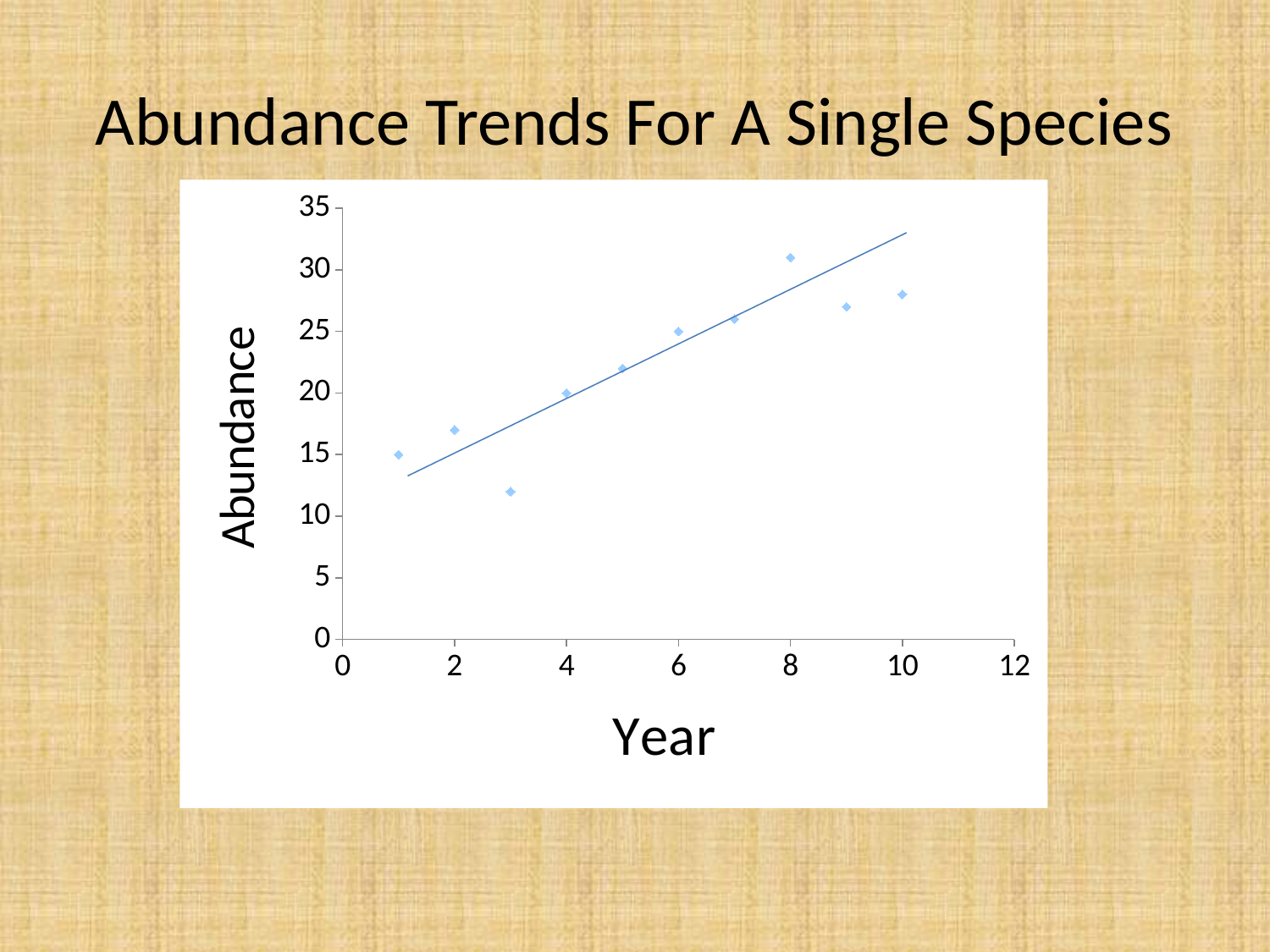
What is the title of the chart? Abundance Trends For A Single Species What is the abundance value in year 1? 15 In which year is abundance highest? 8 What is the label of the y axis? Abundance What kind of chart is shown on the slide? scatter chart Is the abundance value in year 8 greater or less than 30? greater What is the abundance value in year 4? 20 How many data points are plotted on the chart? 10 Which year has the larger abundance, year 2 or year 3? year 2 Do the abundance values generally rise or fall as the year increases? rise Is the abundance value in year 3 greater or less than 15? less In which year is abundance lowest? 3